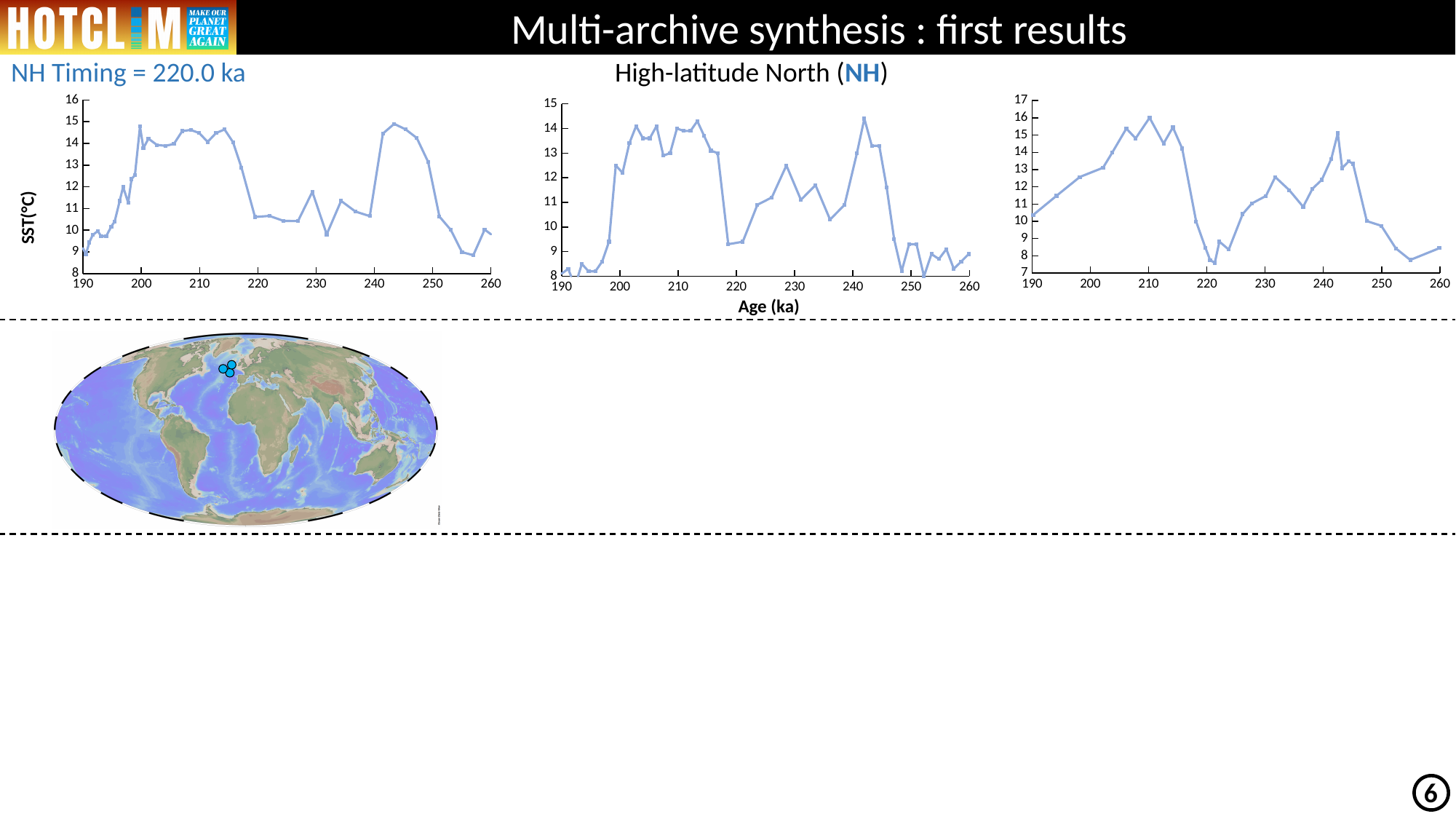
In the right chart, which is larger: the value at 210 ka or the value at 221 ka? 210 ka In the middle chart, is the value at 220 ka greater or less than 10? less What is the label of the x axis shown under the middle chart? Age (ka) In the right chart, is the value at 221 ka greater or less than 9? less In the left chart, does the line rise or fall between 190 ka and 200 ka? rise In the middle chart, is the value at 242 ka greater or less than 13? greater What kind of chart is the left chart on the slide? line chart What is the label of the y axis on the left chart? SST(°C) How many line charts are shown on the slide? 3